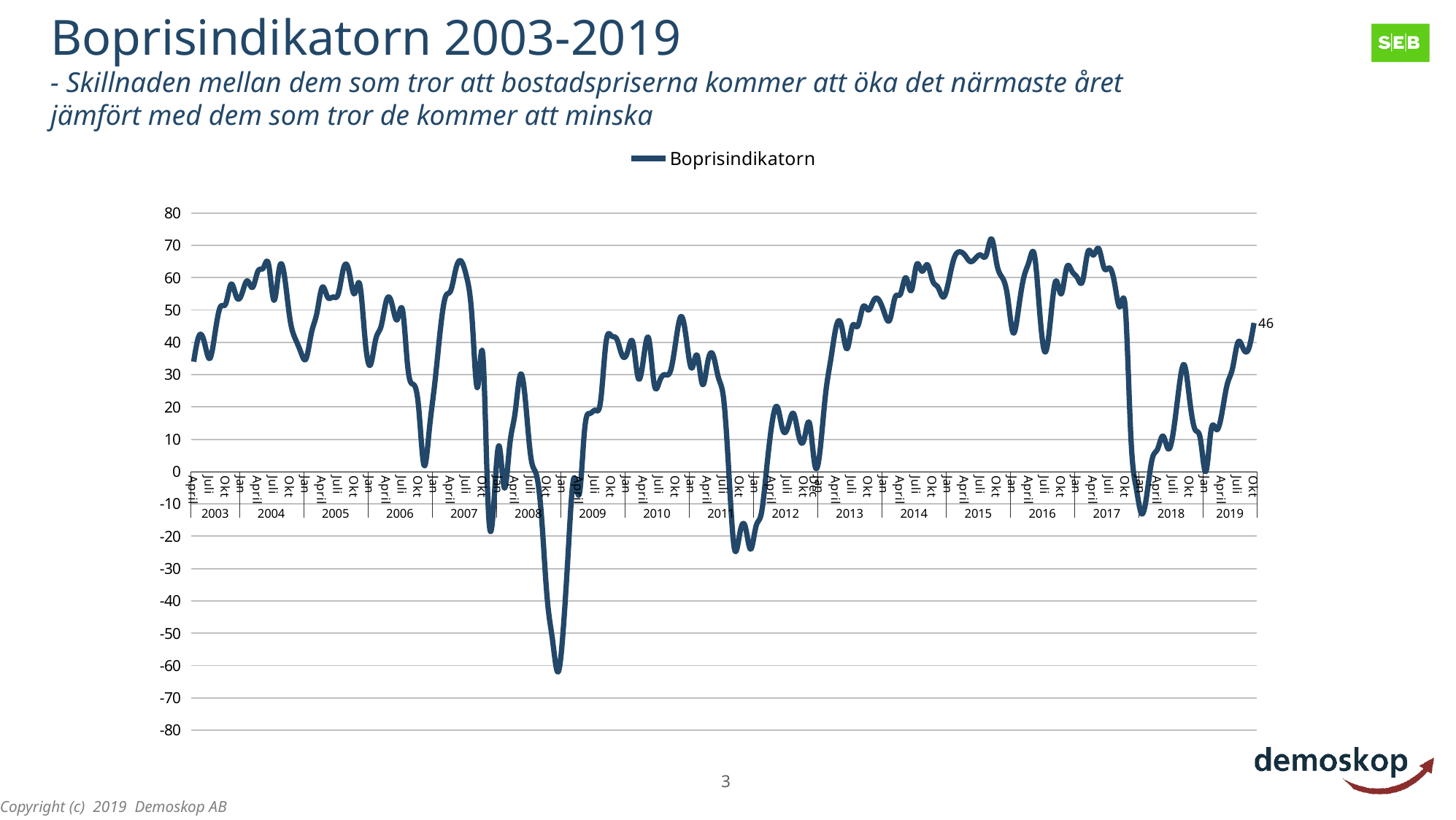
Is the value for Okt 2011 greater or less than -10? less What is the name of the series shown in the legend? Boprisindikatorn What kind of chart is shown on the slide? line chart Is the lowest value of the Boprisindikatorn line greater or less than -50? less What are the lowest and highest values shown on the y axis? -80 and 80 How many series does the legend list? 1 Is the value for Jan 2018 greater or less than 0? less Does the Boprisindikatorn line rise or fall from Jan 2019 to Okt 2019? rise How many years are labelled along the x axis? 17 What is the value of Boprisindikatorn at the last point of the line (Okt 2019)? 46